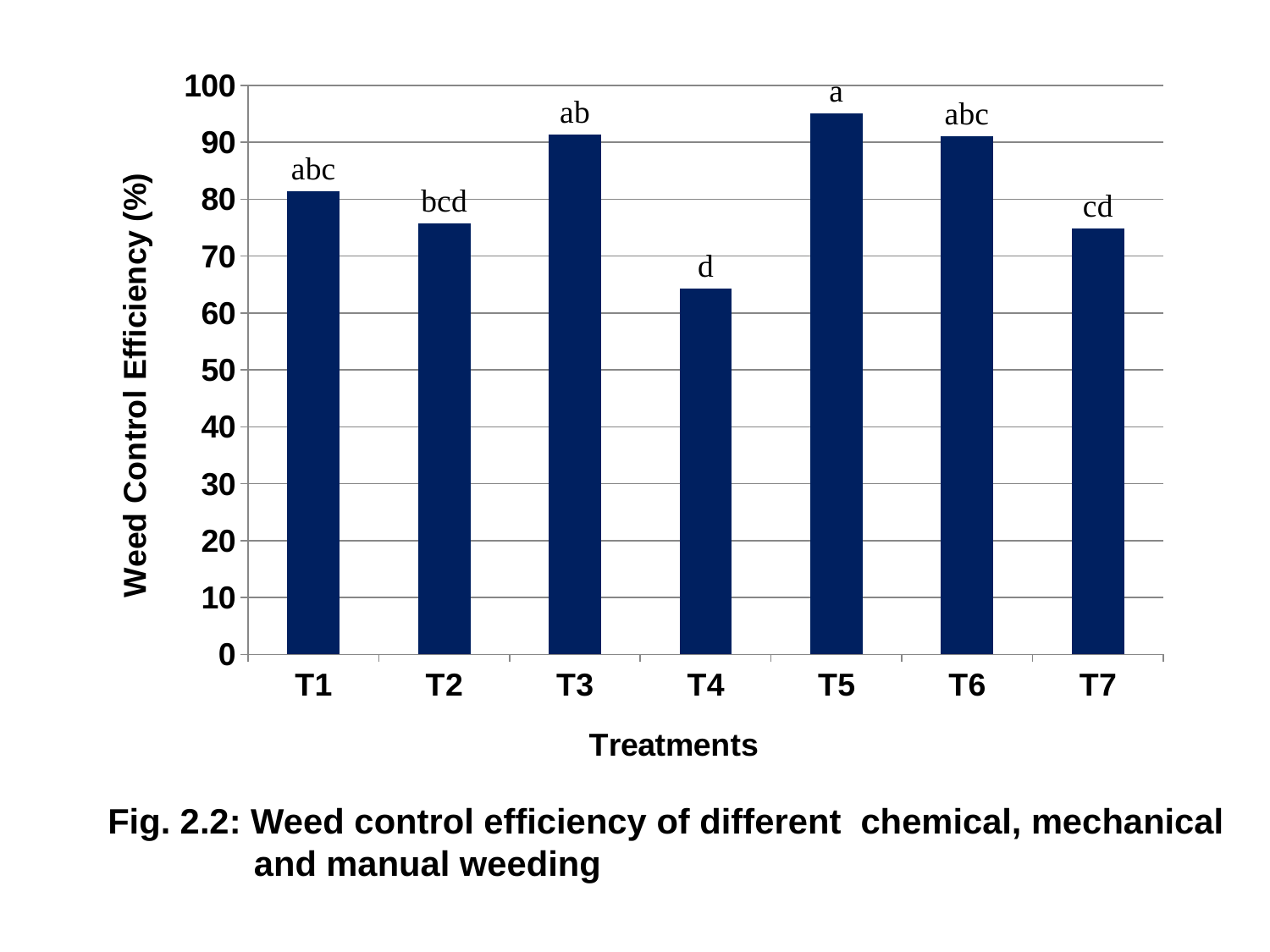
Is the weed control efficiency for T4 greater or less than 70? less Is the weed control efficiency for T1 greater or less than 80? greater Which treatment has the lowest weed control efficiency? T4 Is the weed control efficiency for T5 greater or less than 90? greater What is the label on the y axis? Weed Control Efficiency (%) Which has the higher weed control efficiency, T4 or T7? T7 What kind of chart is shown on the slide? bar chart How many treatments are plotted on the x axis? 7 Which has the higher weed control efficiency, T1 or T2? T1 What letter is printed above the bar for T5? a Which treatment has the highest weed control efficiency? T5